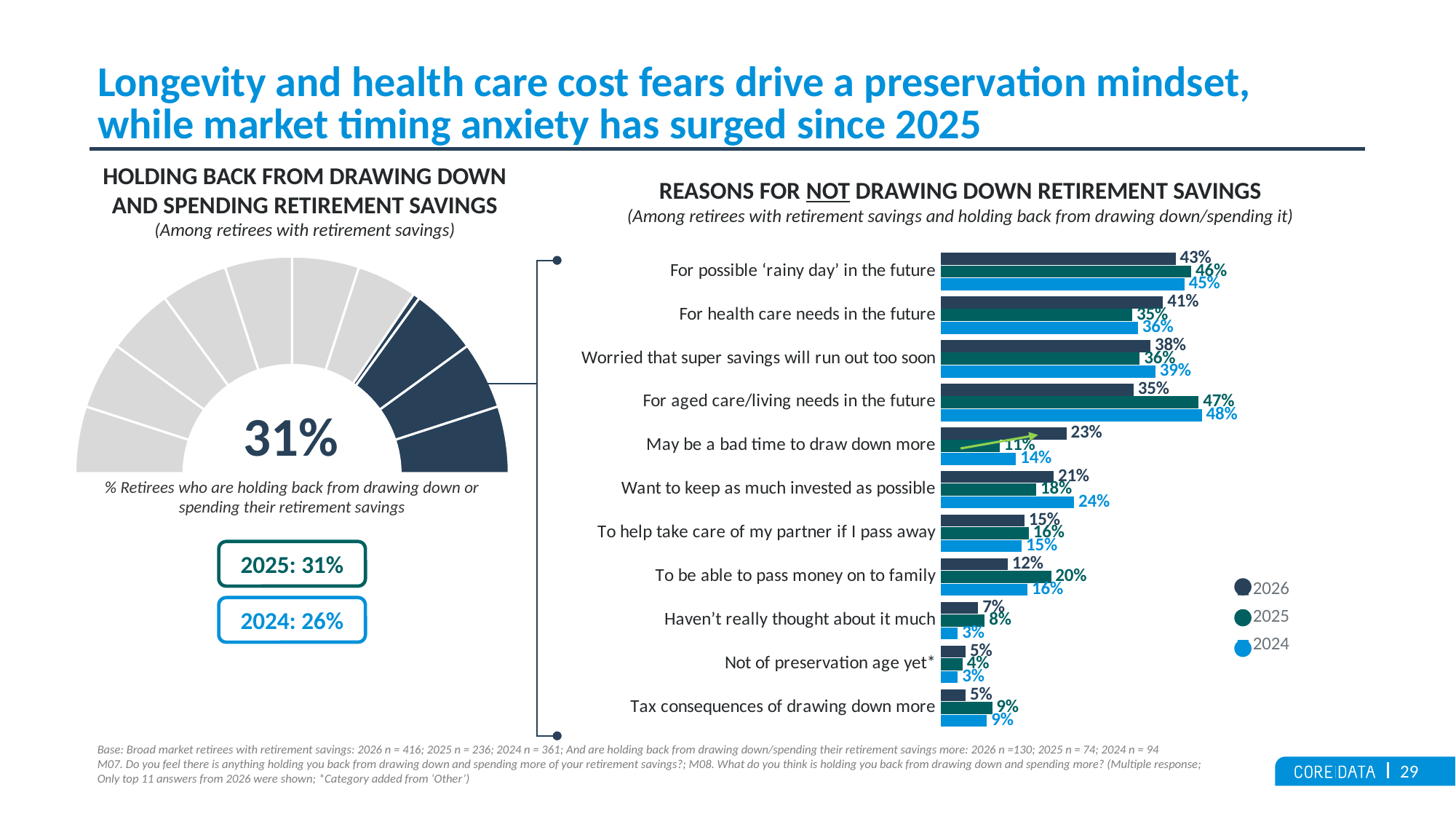
In the 'Reasons for not drawing down retirement savings' chart, which reason has the highest 2026 value? For possible ‘rainy day’ in the future In the 'Reasons for not drawing down retirement savings' chart, what is the 2025 value for 'For aged care/living needs in the future'? 47% How many reasons are listed in the 'Reasons for not drawing down retirement savings' chart? 11 In the 'Holding back from drawing down and spending retirement savings' chart, what was the 2024 value? 26% In the 'Holding back from drawing down and spending retirement savings' gauge chart, what percentage of retirees are holding back from drawing down or spending their retirement savings? 31% How many series does the legend of the 'Reasons for not drawing down retirement savings' chart list? 3 In the 'Reasons for not drawing down retirement savings' chart, what is the 2026 value for 'For possible ‘rainy day’ in the future'? 43% In the 'Reasons for not drawing down retirement savings' chart, what is the 2024 value for 'May be a bad time to draw down more'? 14% In the 'Reasons for not drawing down retirement savings' chart, what is the difference between the 2026 and 2025 values for 'May be a bad time to draw down more'? 12 percentage points In the 'Reasons for not drawing down retirement savings' chart, which reason has the lowest 2024 value? Haven’t really thought about it much and Not of preservation age yet* (both 3%) In the 'Reasons for not drawing down retirement savings' chart, which is larger for 'To be able to pass money on to family': the 2026 value or the 2025 value? 2025 What kind of chart is the 'Reasons for not drawing down retirement savings' chart? Bar chart